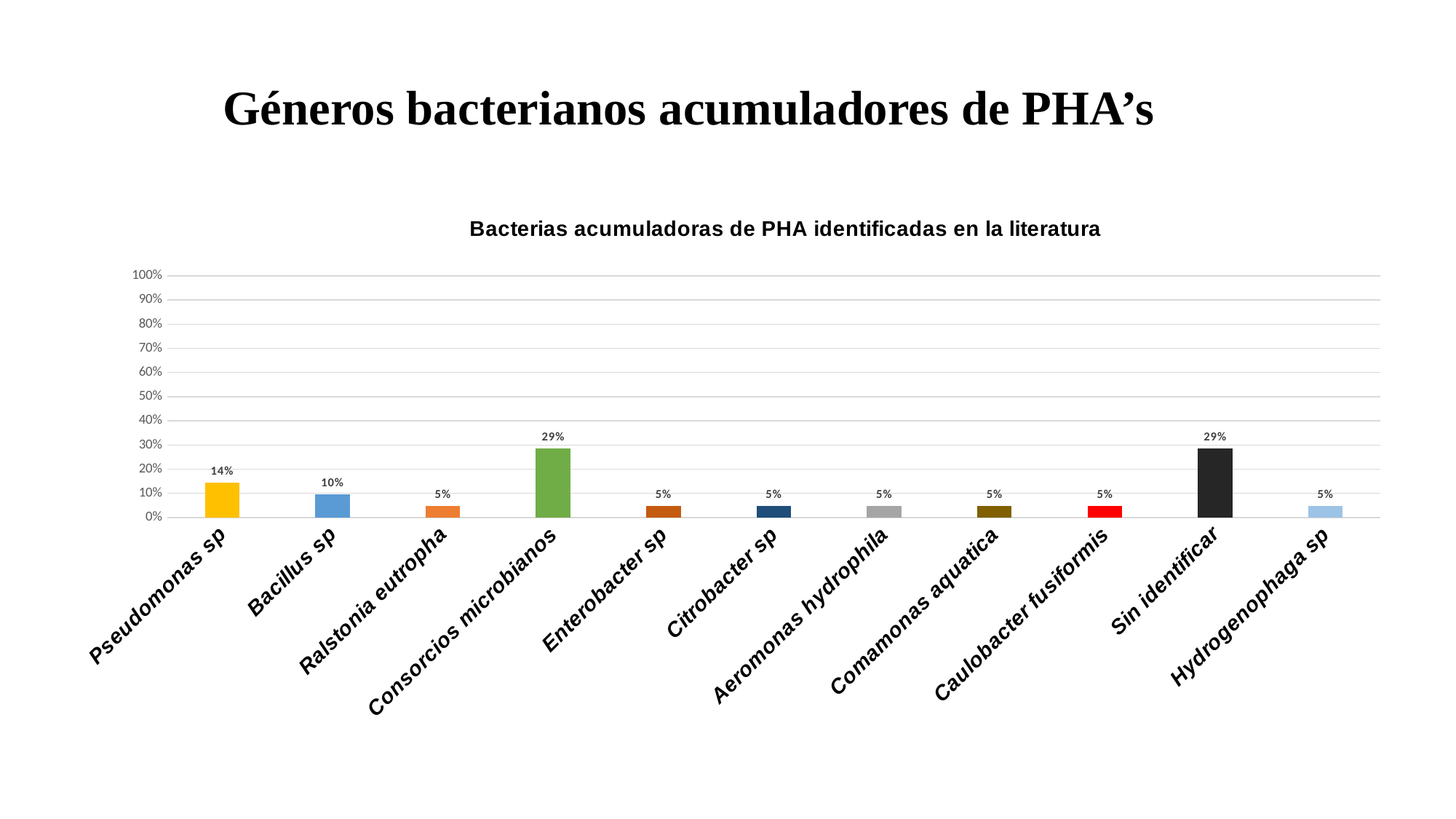
What is the value for Consorcios microbianos? 29% What is the highest value shown in the chart? 29% What type of chart is shown on the slide? Bar chart What is the value for Bacillus sp? 10% Which has a larger value, Bacillus sp or Ralstonia eutropha? Bacillus sp What is the value for Hydrogenophaga sp? 5% What is the difference between the values for Consorcios microbianos and Pseudomonas sp? 15% What is the lowest value shown in the chart? 5% How many categories are shown in the chart? 11 What is the difference between the values for Pseudomonas sp and Bacillus sp? 4% What is the value for Pseudomonas sp? 14% What is the value for Sin identificar? 29%